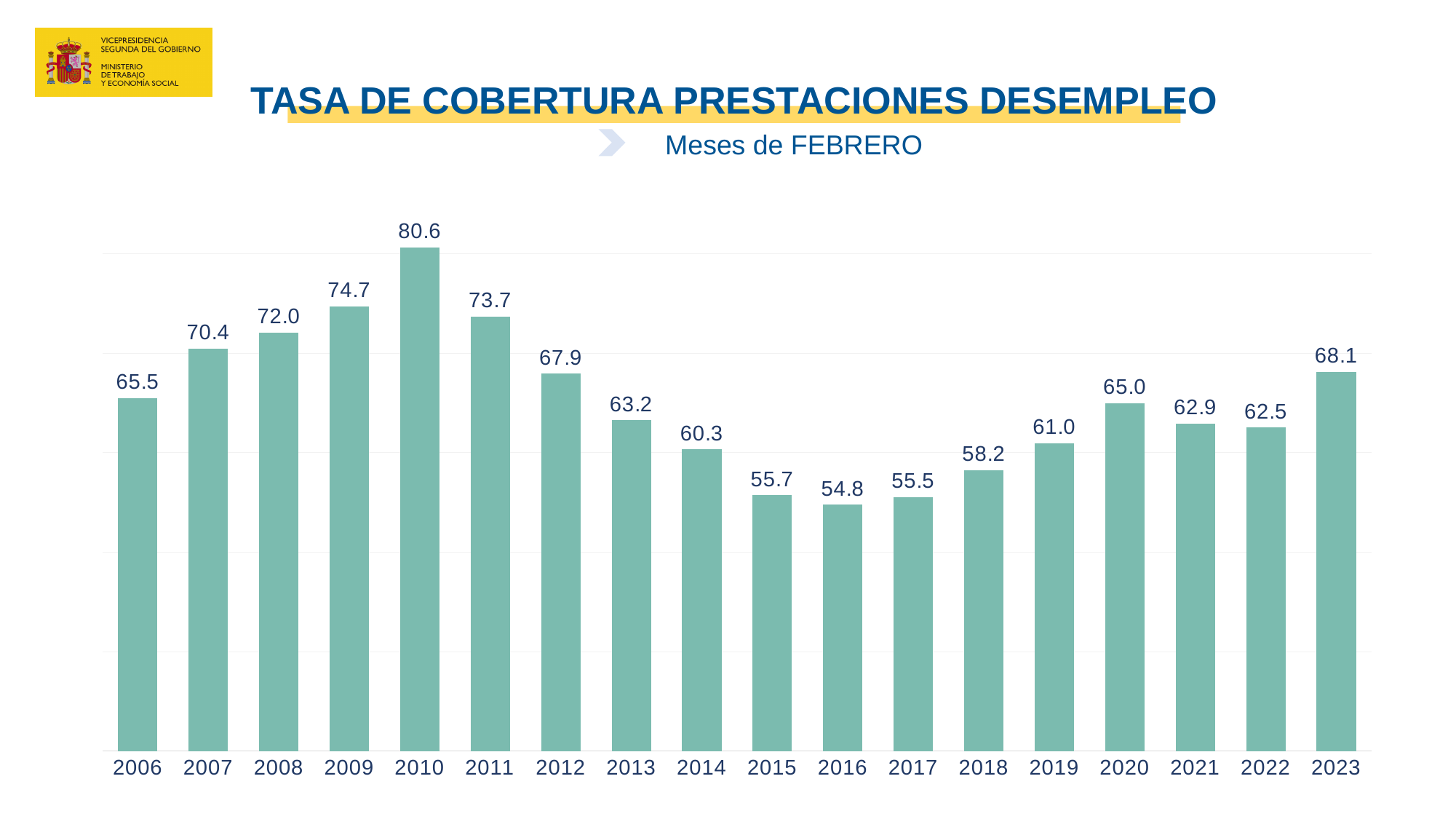
What is the value for 2016? 54.8 What is the value for 2010? 80.6 How many years are shown on the x axis? 18 What is the value for 2023? 68.1 Which year has the lowest value? 2016 What kind of chart is shown? bar chart What is the difference between the values for 2010 and 2016? 25.8 Which year has the highest value? 2010 Do the values rise or fall from 2010 to 2016? fall What is the difference between the values for 2023 and 2022? 5.6 Which is larger, the value for 2006 or the value for 2020? 2006 What is the title of the chart? TASA DE COBERTURA PRESTACIONES DESEMPLEO